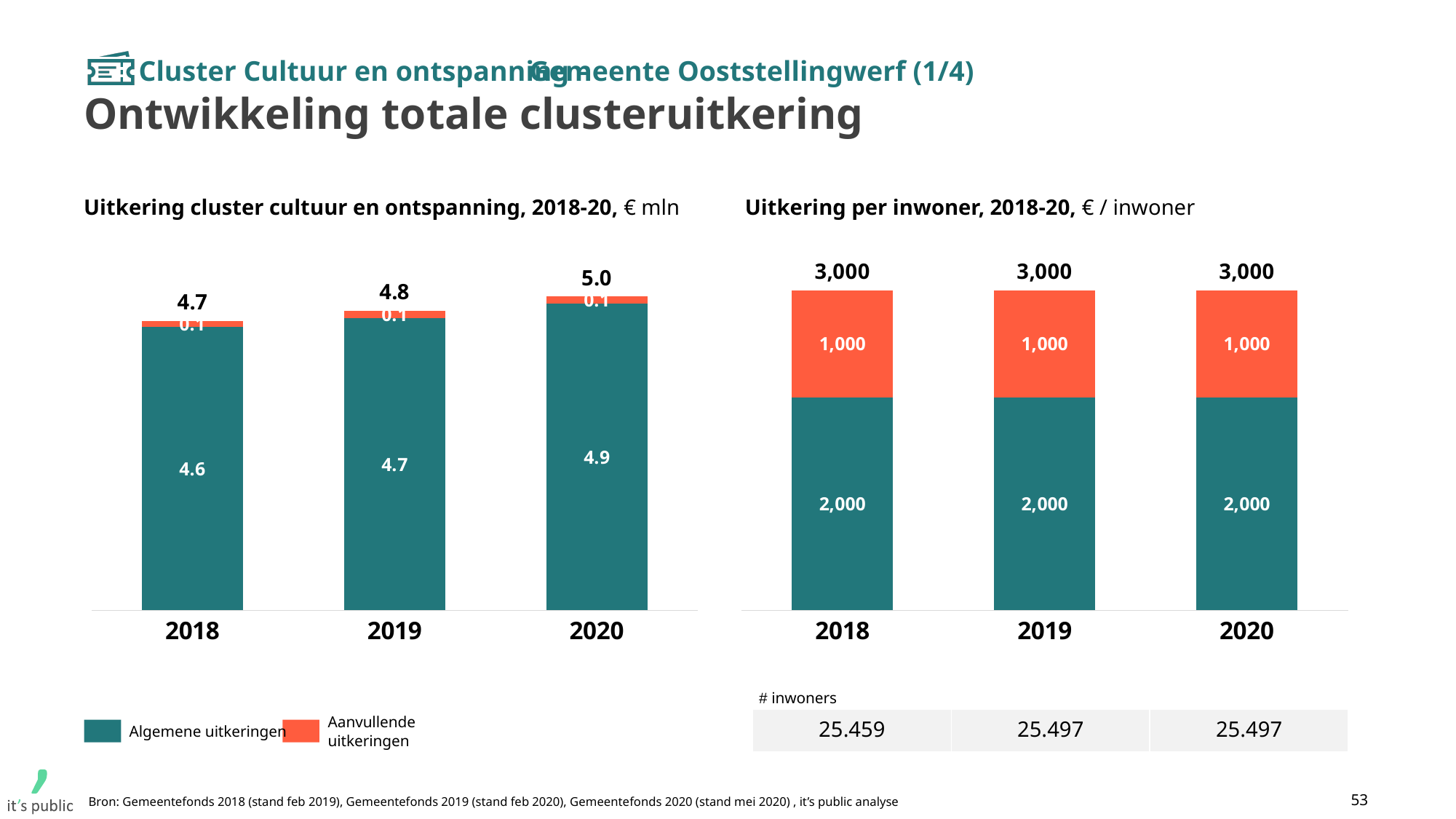
In the chart 'Uitkering cluster cultuur en ontspanning, 2018-20', what is the total uitkering for 2020? 5.0 In the chart 'Uitkering cluster cultuur en ontspanning, 2018-20', which year has the lowest total uitkering? 2018 In the chart 'Uitkering cluster cultuur en ontspanning, 2018-20', which year has the highest total uitkering? 2020 In the chart 'Uitkering cluster cultuur en ontspanning, 2018-20', what is the value of Algemene uitkeringen in 2018? 4.6 In the chart 'Uitkering per inwoner, 2018-20', what is the total uitkering per inwoner in 2018? 3,000 In the chart 'Uitkering per inwoner, 2018-20', what is the value of Aanvullende uitkeringen in 2020? 1,000 In the chart 'Uitkering cluster cultuur en ontspanning, 2018-20', what is the value of Aanvullende uitkeringen in 2019? 0.1 In the chart 'Uitkering per inwoner, 2018-20', what is the value of Algemene uitkeringen in 2019? 2,000 How many series does the legend list for the chart 'Uitkering cluster cultuur en ontspanning, 2018-20'? 2 What kind of chart is 'Uitkering per inwoner, 2018-20'? stacked bar chart In the chart 'Uitkering cluster cultuur en ontspanning, 2018-20', what is the difference between the total for 2020 and the total for 2018? 0.3 In the chart 'Uitkering cluster cultuur en ontspanning, 2018-20', does the total uitkering rise or fall from 2018 to 2020? rise